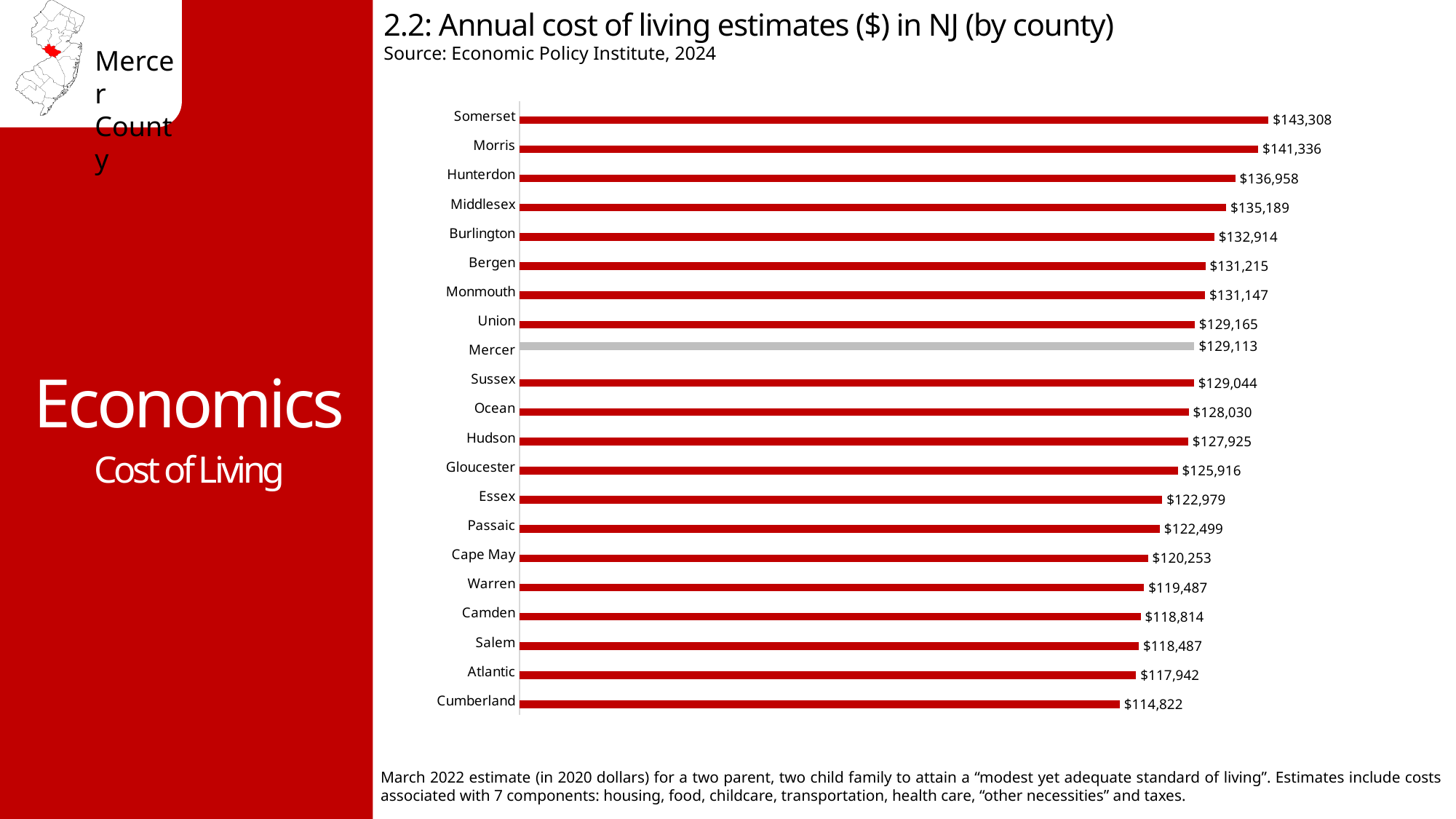
Which county has the highest annual cost of living estimate? Somerset Which county's bar is shown in grey instead of red? Mercer Which county has a higher cost of living estimate, Essex or Camden? Essex How many counties are shown in the chart? 21 What is the annual cost of living estimate for Somerset County? $143,308 Which county has the lowest annual cost of living estimate? Cumberland What is the difference between the cost of living estimates for Mercer and Cumberland counties? $14,291 What is the difference between the cost of living estimates for Somerset and Cumberland counties? $28,486 What is the annual cost of living estimate for Mercer County? $129,113 What is the annual cost of living estimate for Hudson County? $127,925 Which county has a higher cost of living estimate, Morris or Hunterdon? Morris What type of chart is used to show the cost of living estimates? Bar chart